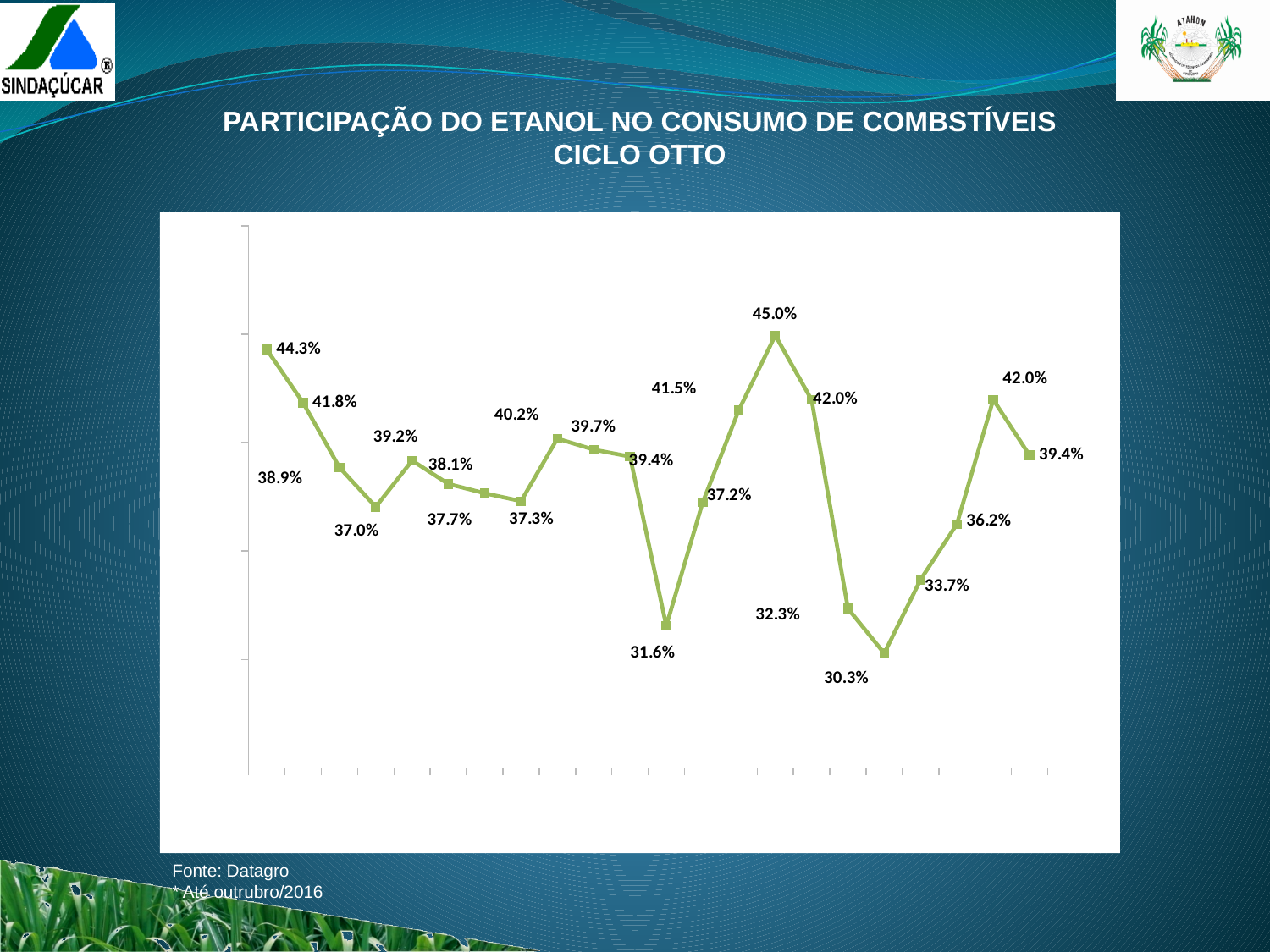
Does the line rise or fall between the point labelled 31.6% and the point labelled 45.0%? rise What is the difference between the first point (44.3%) and the second point (41.8%) on the line? 2.5 percentage points What is the value of the first (leftmost) point on the line? 44.3% How many data points are plotted on the line? 22 What is the highest value labelled on the line? 45.0% What is the title of the chart on the slide? PARTICIPAÇÃO DO ETANOL NO CONSUMO DE COMBSTÍVEIS CICLO OTTO Which is larger, the first point on the line (44.3%) or the last point (39.4%)? the first point (44.3%) What is the difference between the highest labelled value (45.0%) and the lowest labelled value (30.3%)? 14.7 percentage points What source is cited for the chart data? Datagro What is the lowest value labelled on the line? 30.3% What is the value of the last (rightmost) point on the line? 39.4% What kind of chart is shown on the slide? line chart